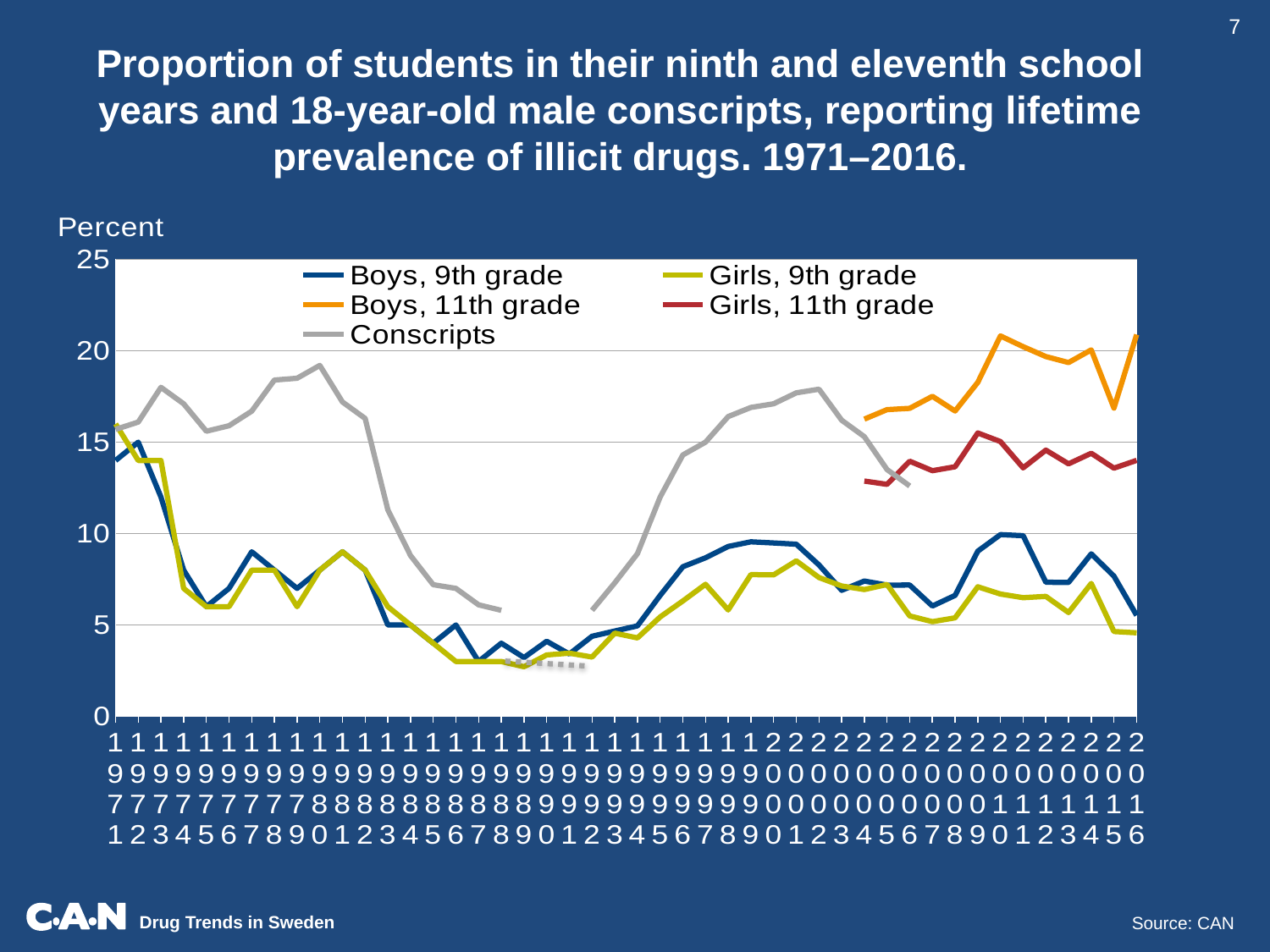
Does the Conscripts line rise or fall between 1979 and 1989? Falls What kind of chart is shown on the slide? Line chart How many series does the legend list? 5 Is the value for Conscripts in 1979 greater or less than 15? greater In 2016, which is higher: Boys, 11th grade or Girls, 11th grade? Boys, 11th grade Which colour is used for the Conscripts line? Grey Which series has the highest value in 2016? Boys, 11th grade Which series has the lowest value in 2016? Girls, 9th grade What is the label on the vertical axis? Percent Is the value for Girls, 11th grade in 2016 greater or less than 10? greater Is the value for Girls, 9th grade in 2016 greater or less than 5? less